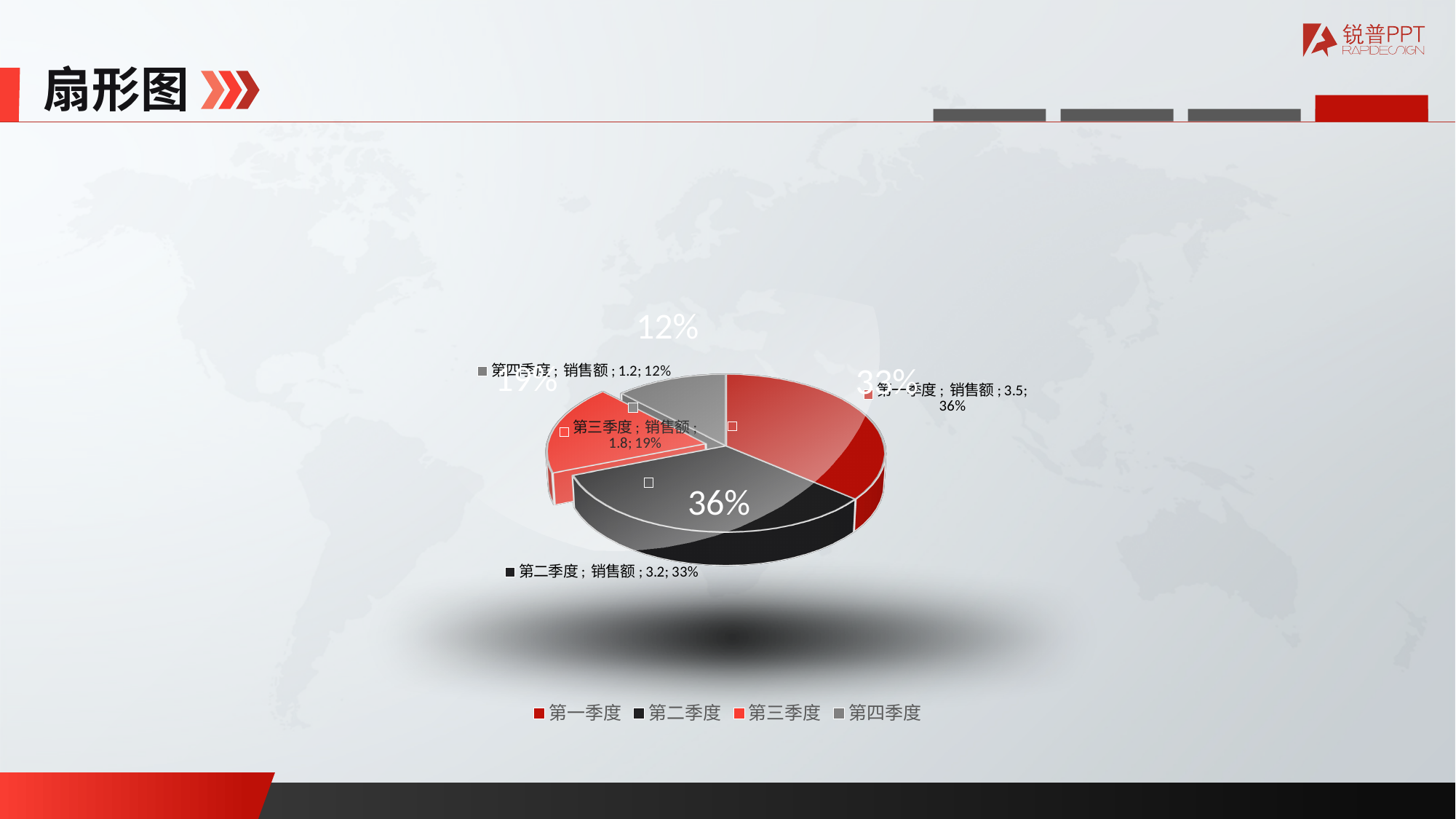
What is the difference in 销售额 between 第一季度 and 第二季度? 0.3 What is the title of the slide containing the pie chart? 扇形图 What is the 销售额 value for 第二季度? 3.2 What is the 销售额 value for 第四季度? 1.2 Which quarter has the smallest slice of the pie? 第四季度 How many slices does the pie chart have? 4 What share of the pie does 第三季度 represent? 19% Which quarter has the largest slice of the pie? 第一季度 What is the 销售额 value for 第三季度? 1.8 What is the 销售额 value for 第一季度? 3.5 What share of the pie does 第四季度 represent? 12% What kind of chart is shown on the slide? pie chart